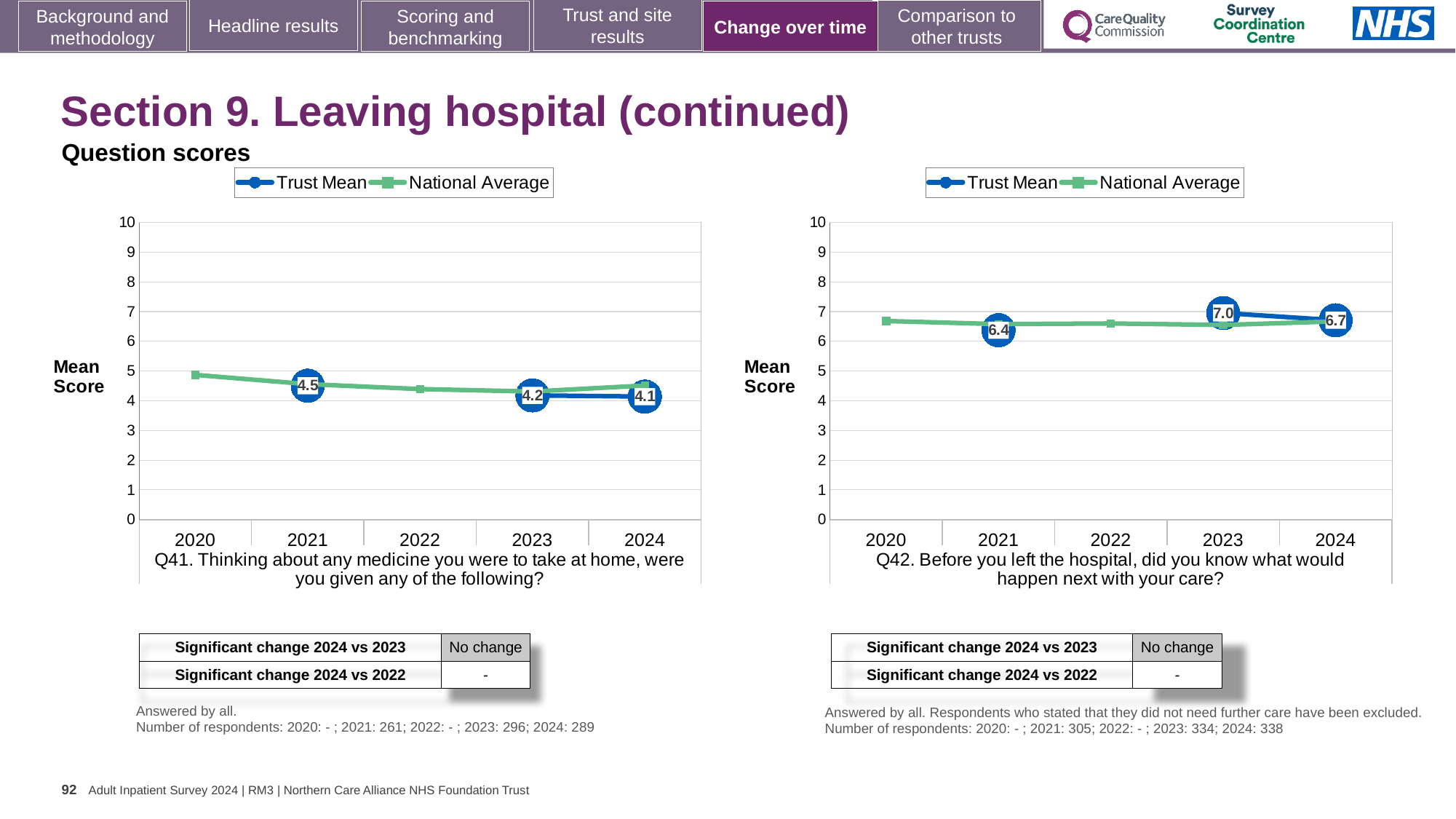
In the Q41 chart on the left, what is the difference between the Trust Mean scores for 2021 and 2024? 0.4 In the Q42 chart on the right, what is the Trust Mean score for 2021? 6.4 How many series does the legend of the Q42 chart on the right list? 2 In the Q42 chart on the right, which year has the highest Trust Mean score? 2023 In the Q42 chart on the right, what is the Trust Mean score for 2023? 7.0 In the Q41 chart on the left, which year has the lowest labelled Trust Mean score? 2024 In the Q41 chart on the left, is the National Average value for 2020 greater or less than 5? less What kind of chart is the Q41 chart on the left? Line chart In the Q42 chart on the right, what is the difference between the Trust Mean scores for 2023 and 2024? 0.3 In the Q41 chart on the left, what is the Trust Mean score for 2021? 4.5 In the Q41 chart on the left, what is the Trust Mean score for 2024? 4.1 In the Q42 chart on the right, is the Trust Mean score higher in 2021 or in 2024? 2024